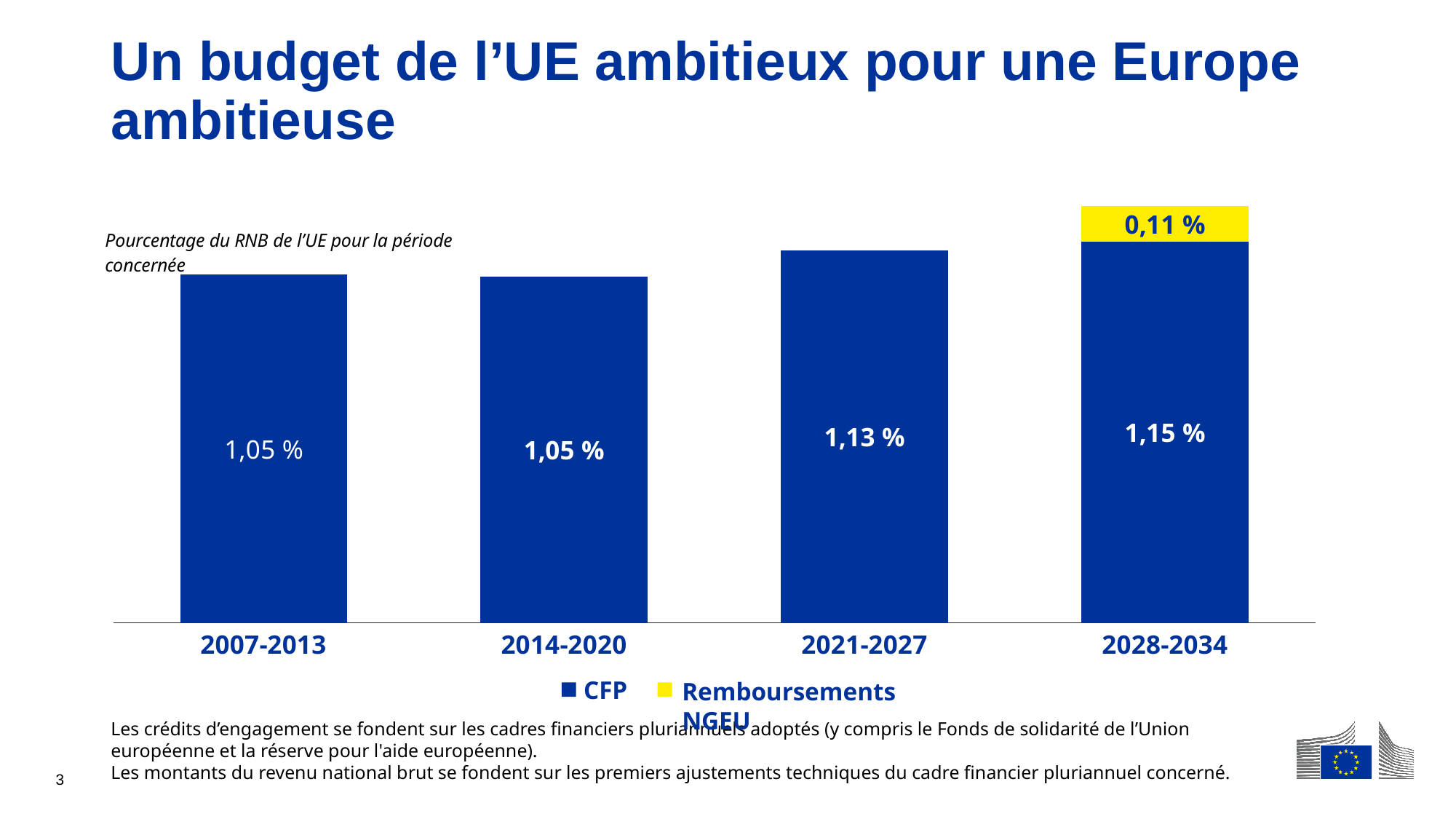
What is the difference between the CFP values for 2028-2034 and 2014-2020? 0,10 % Do the CFP values rise or fall from 2014-2020 to 2028-2034? Rise What is the CFP value for 2021-2027? 1,13 % How many periods are shown on the x axis? 4 Which is larger, the CFP value for 2021-2027 or for 2014-2020? 2021-2027 What is the Remboursements NGEU value for 2028-2034? 0,11 % What is the CFP value for 2007-2013? 1,05 % Which period has the highest CFP value? 2028-2034 What kind of chart is shown on the slide? Stacked bar chart What is the CFP value for 2028-2034? 1,15 % How many series does the legend list? 2 What is the total of the stacked bar for 2028-2034? 1,26 %